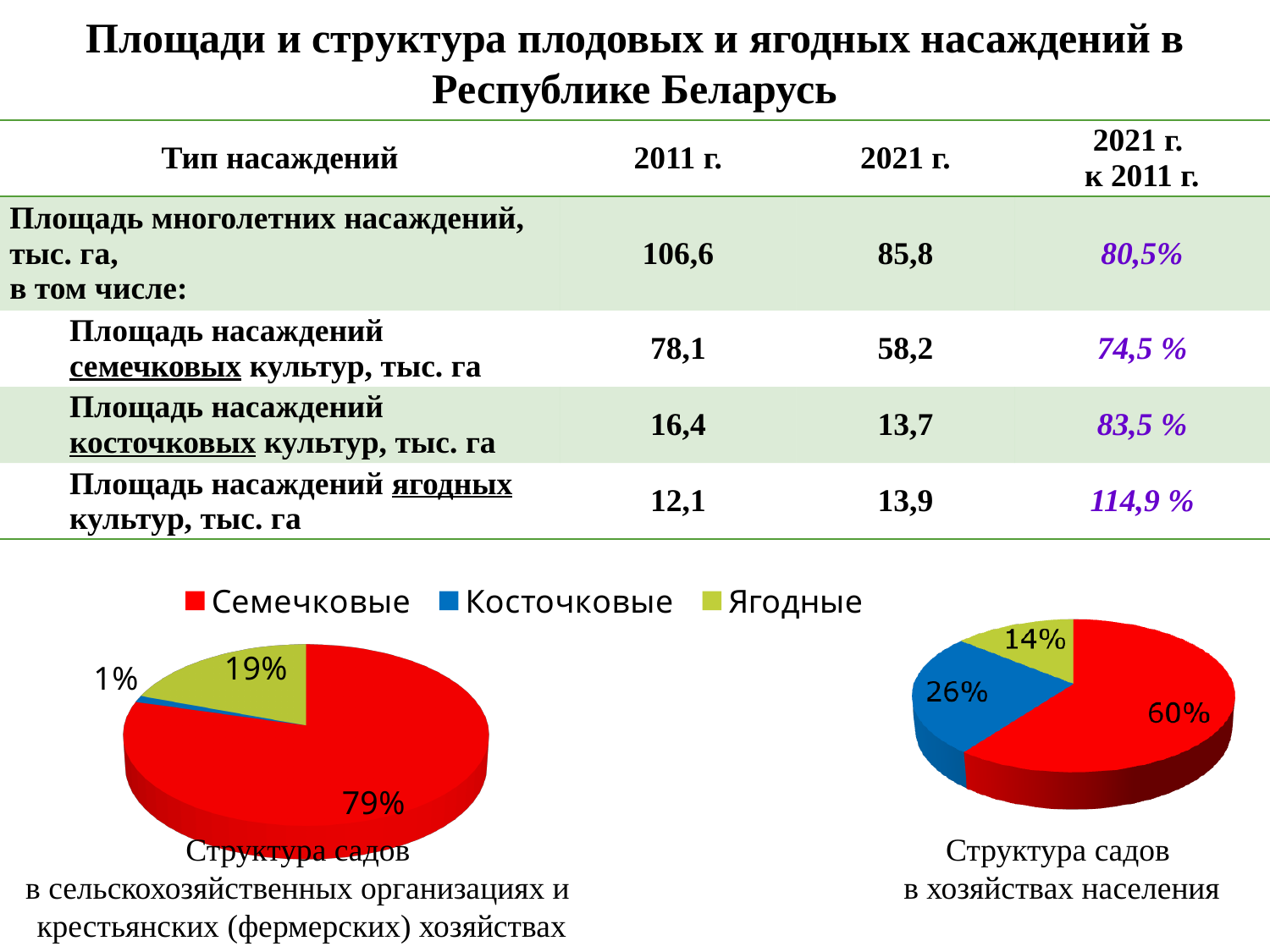
In the left pie chart (сельскохозяйственные организации и фермерские хозяйства), what share do Семечковые have? 79% How many entries does the shared legend of the pie charts list? 3 In the right pie chart (Структура садов в хозяйствах населения), what share do Ягодные have? 14% In the left pie chart (сельскохозяйственные организации и фермерские хозяйства), what share do Ягодные have? 19% In the right pie chart (Структура садов в хозяйствах населения), which category has the smallest share? Ягодные In the right pie chart (Структура садов в хозяйствах населения), what is the difference between the shares of Семечковые and Косточковые? 34% In the right pie chart (Структура садов в хозяйствах населения), what share do Косточковые have? 26% What kind of chart is the left chart (Структура садов в сельскохозяйственных организациях и крестьянских (фермерских) хозяйствах)? pie chart Which is larger: the share of Косточковые in the left pie chart or in the right pie chart? the right pie chart (хозяйства населения) In the left pie chart (сельскохозяйственные организации и фермерские хозяйства), which category has the largest share? Семечковые In the left pie chart (сельскохозяйственные организации и фермерские хозяйства), what share do Косточковые have? 1% In the right pie chart (Структура садов в хозяйствах населения), what share do Семечковые have? 60%